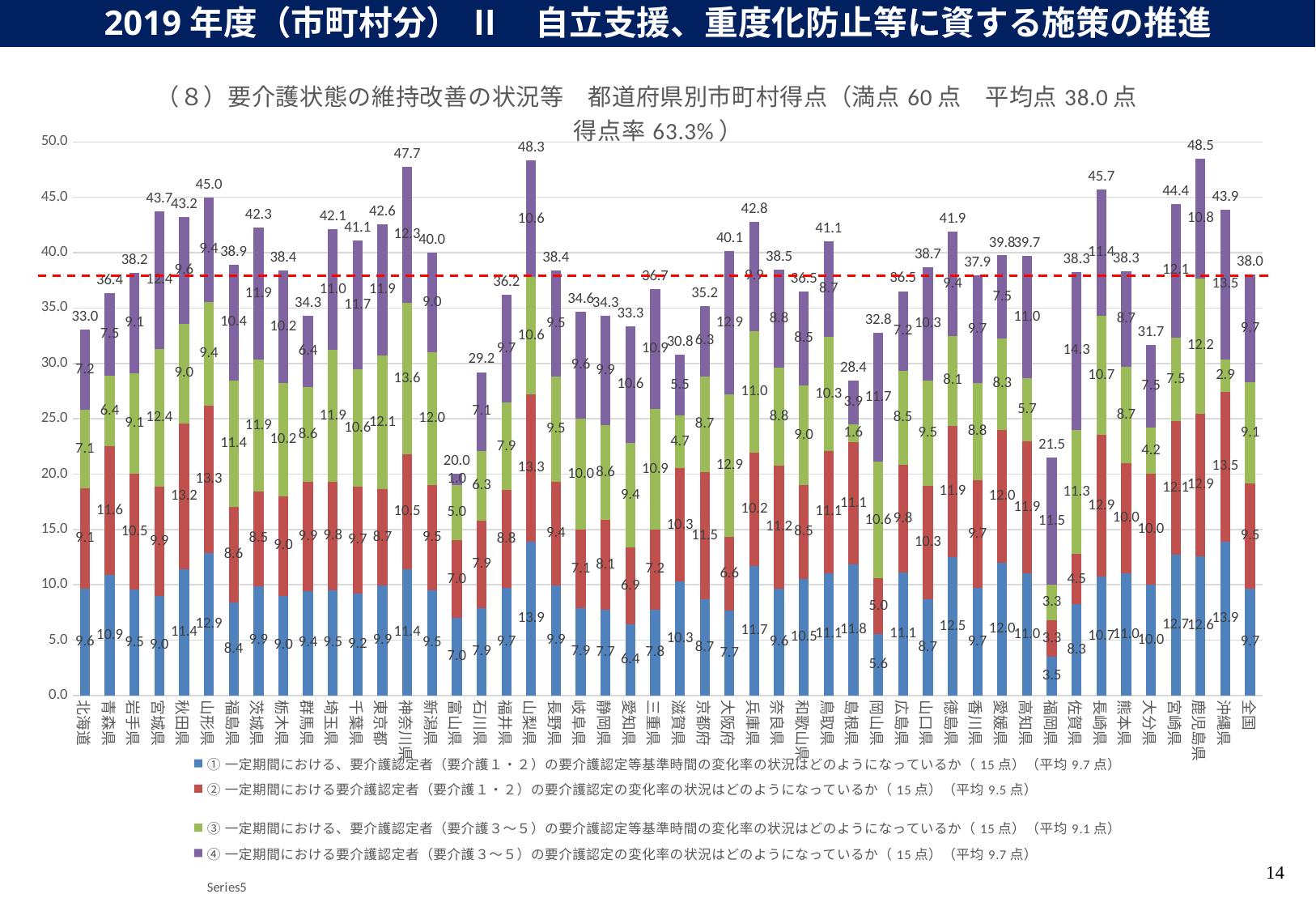
What is the difference between the total scores of 山梨県 and 富山県? 28.3 According to the chart title, what is the average score (平均点)? 38.0点 What is the total score for 福岡県? 21.5 What is the total score for 神奈川県? 47.7 Which prefecture has the highest total score? 鹿児島県 What is the total score shown for 全国? 38.0 Which prefecture has the lowest total score? 富山県 What is the total score for 北海道? 33.0 Which has a higher total score, 宮城県 or 秋田県? 宮城県 What is the difference between the total scores of 鹿児島県 and 沖縄県? 4.6 How many categories (bars) are plotted on the x axis? 48 What kind of chart is shown on the slide? Stacked bar chart